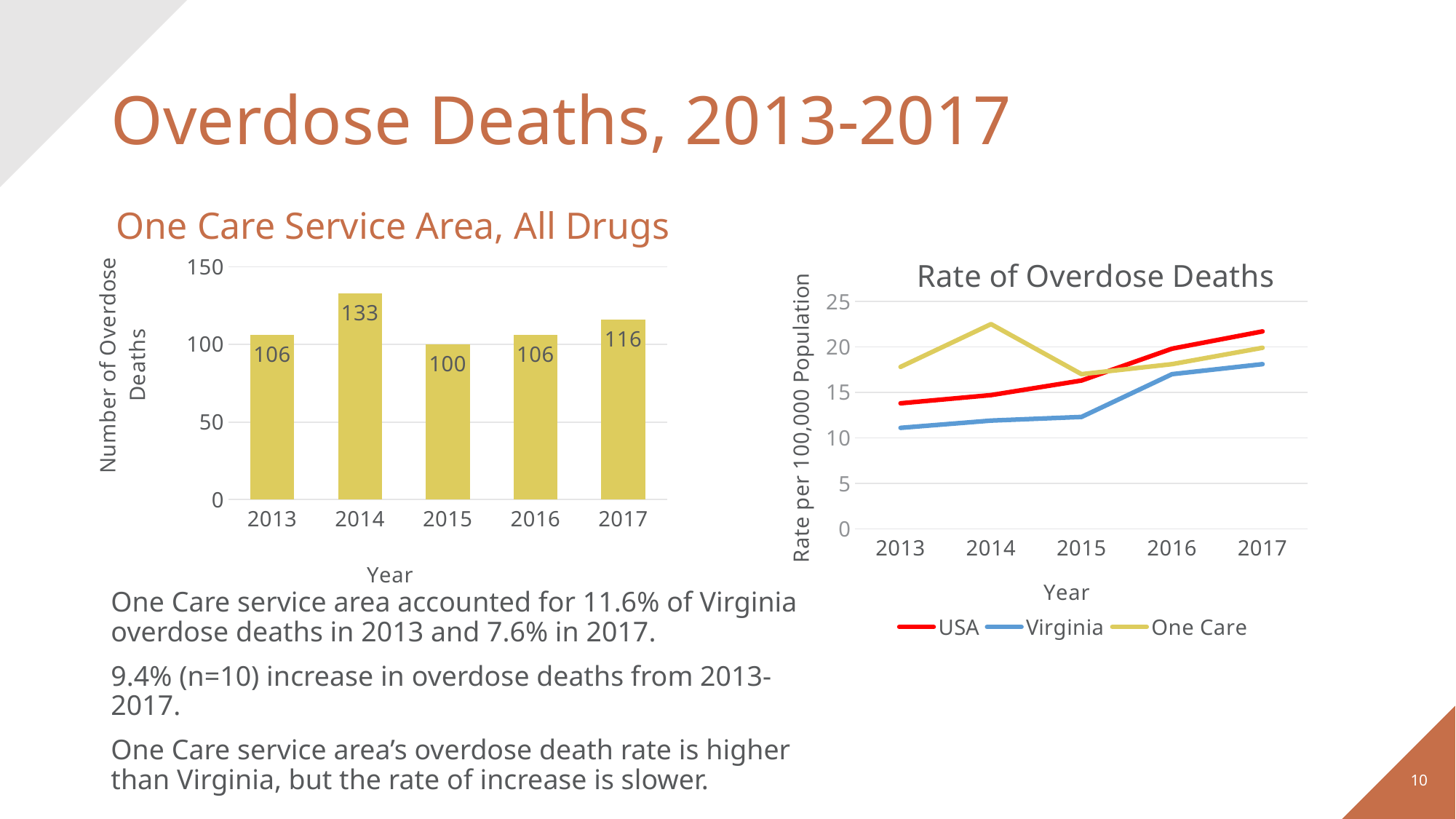
In the 'One Care Service Area, All Drugs' chart, how many overdose deaths were there in 2017? 116 In the 'Rate of Overdose Deaths' chart, does the Virginia rate rise or fall from 2013 to 2017? Rise In the 'One Care Service Area, All Drugs' chart, how many overdose deaths were there in 2014? 133 In the 'One Care Service Area, All Drugs' chart, which year had the lowest number of overdose deaths? 2015 In the 'Rate of Overdose Deaths' chart, how many series does the legend list? 3 In the 'One Care Service Area, All Drugs' chart, how many years are shown on the x axis? 5 In the 'One Care Service Area, All Drugs' chart, which year had more overdose deaths, 2013 or 2017? 2017 In the 'Rate of Overdose Deaths' chart, which series is shown in red? USA What kind of chart is the 'One Care Service Area, All Drugs' chart? Bar chart In the 'One Care Service Area, All Drugs' chart, which year had the highest number of overdose deaths? 2014 In the 'Rate of Overdose Deaths' chart, is the USA rate in 2017 greater or less than 20? greater In the 'One Care Service Area, All Drugs' chart, what is the difference between the number of overdose deaths in 2014 and 2015? 33